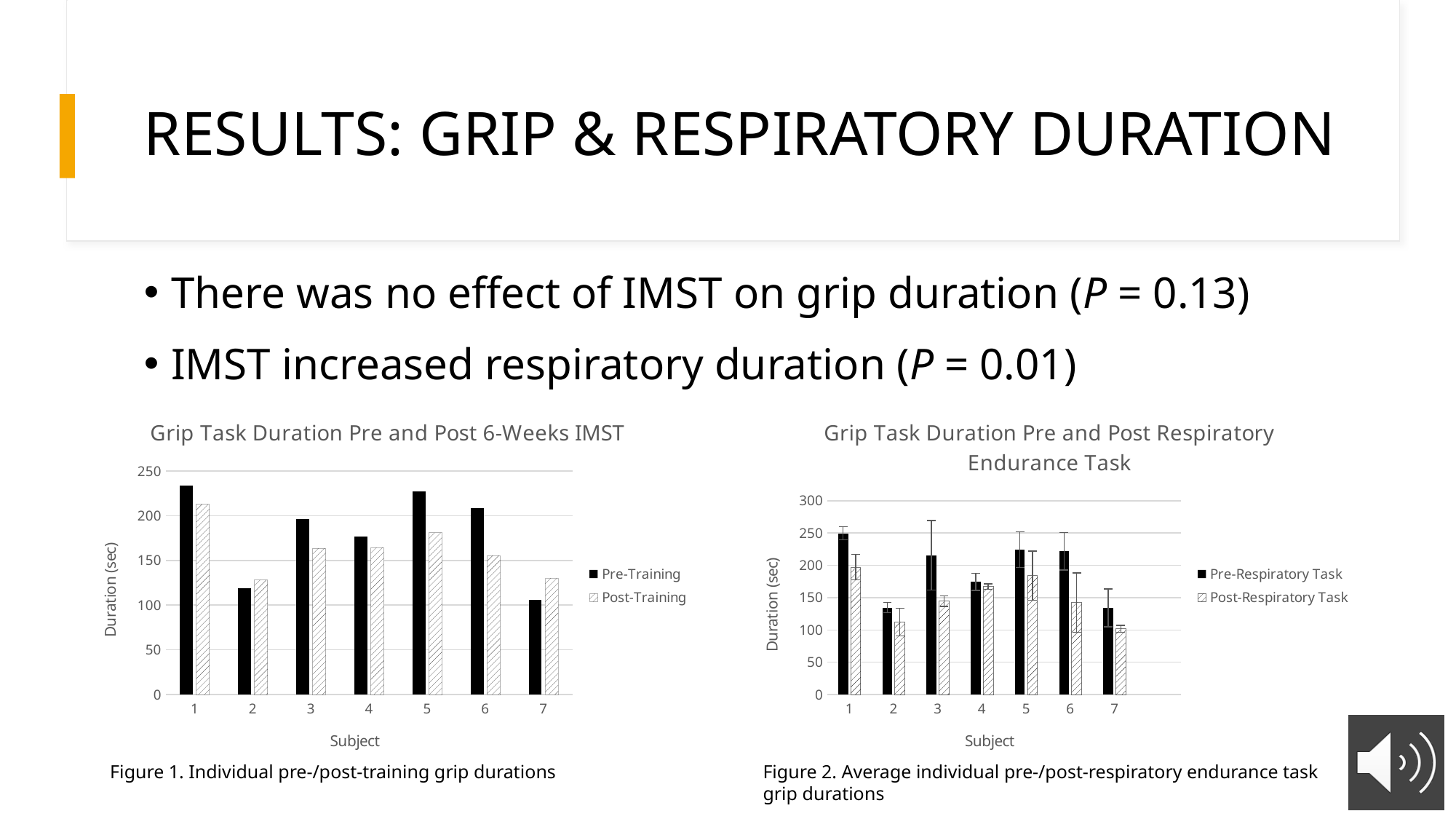
In the right chart, 'Grip Task Duration Pre and Post Respiratory Endurance Task', is the Pre-Respiratory Task value for subject 2 greater or less than 150? less In the right chart, 'Grip Task Duration Pre and Post Respiratory Endurance Task', for subject 3, which is larger: Pre-Respiratory Task or Post-Respiratory Task? Pre-Respiratory Task In the right chart, 'Grip Task Duration Pre and Post Respiratory Endurance Task', which subject has the highest Pre-Respiratory Task duration? Subject 1 In the left chart, 'Grip Task Duration Pre and Post 6-Weeks IMST', is the Pre-Training value for subject 1 greater or less than 200? greater In the left chart, 'Grip Task Duration Pre and Post 6-Weeks IMST', how many series does the legend list? 2 In the left chart, 'Grip Task Duration Pre and Post 6-Weeks IMST', for subject 3, which is larger: Pre-Training or Post-Training? Pre-Training What type of chart is the left chart, 'Grip Task Duration Pre and Post 6-Weeks IMST'? Bar chart In the left chart, 'Grip Task Duration Pre and Post 6-Weeks IMST', which subject has the highest Post-Training duration? Subject 1 In the left chart, 'Grip Task Duration Pre and Post 6-Weeks IMST', which subject has the lowest Pre-Training duration? Subject 7 In the left chart, 'Grip Task Duration Pre and Post 6-Weeks IMST', for subject 2, which is larger: Pre-Training or Post-Training? Post-Training In the left chart, 'Grip Task Duration Pre and Post 6-Weeks IMST', how many subjects are shown on the x axis? 7 What is the y-axis label of the right chart, 'Grip Task Duration Pre and Post Respiratory Endurance Task'? Duration (sec)